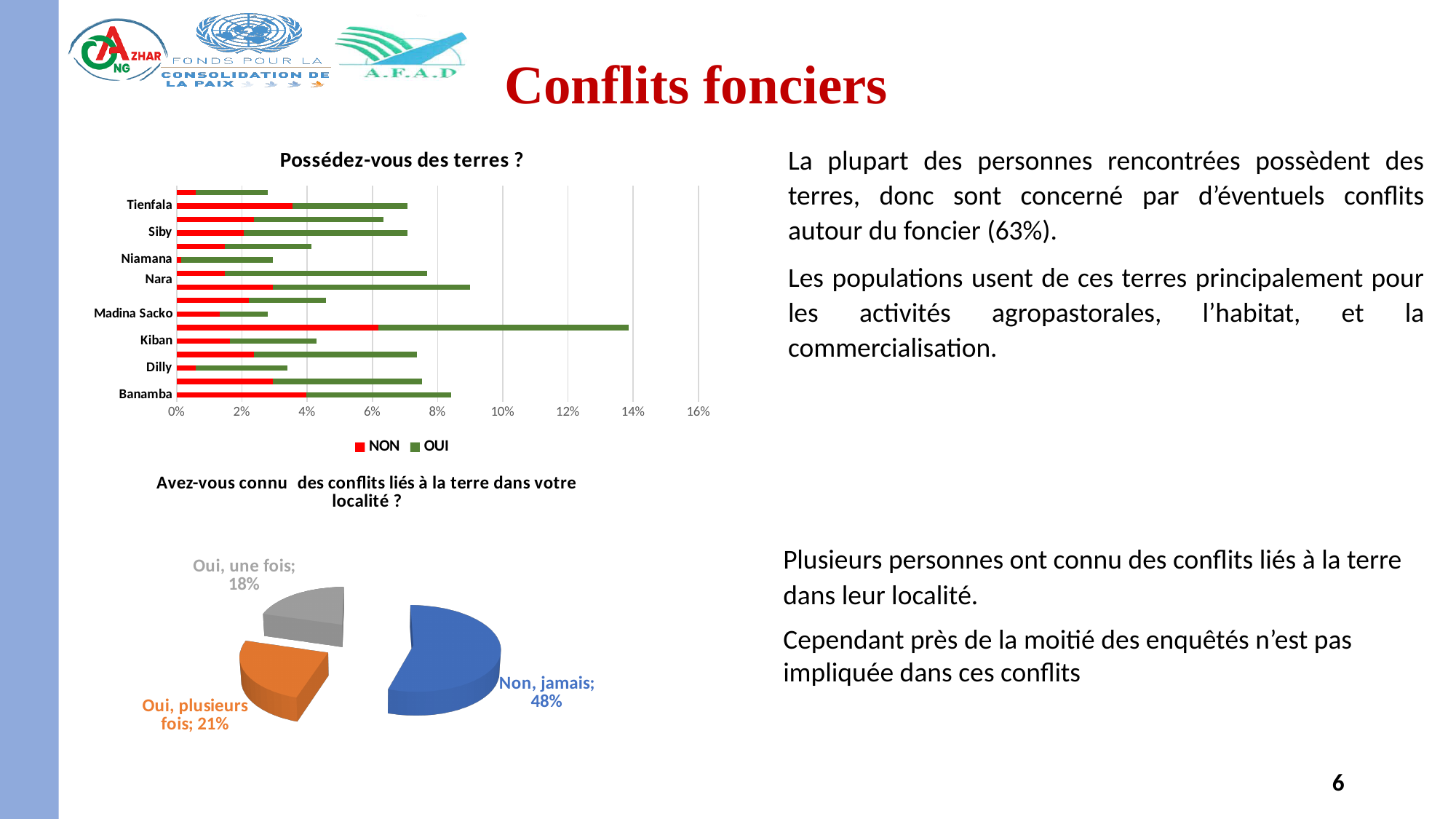
In the pie chart 'Avez-vous connu des conflits liés à la terre dans votre localité ?', what share is labelled 'Oui, une fois'? 18% In the pie chart 'Avez-vous connu des conflits liés à la terre dans votre localité ?', which slice is the largest? Non, jamais In the bar chart 'Possédez-vous des terres ?', how many series does the legend list? 2 In the pie chart 'Avez-vous connu des conflits liés à la terre dans votre localité ?', how many percentage points larger is 'Non, jamais' than 'Oui, plusieurs fois'? 27 In the pie chart 'Avez-vous connu des conflits liés à la terre dans votre localité ?', what share is labelled 'Oui, plusieurs fois'? 21% In the pie chart 'Avez-vous connu des conflits liés à la terre dans votre localité ?', which slice is the smallest? Oui, une fois In the pie chart 'Avez-vous connu des conflits liés à la terre dans votre localité ?', how many slices are shown? 3 In the bar chart 'Possédez-vous des terres ?', is the OUI value for Niamana greater or less than 4%? less In the pie chart 'Avez-vous connu des conflits liés à la terre dans votre localité ?', what share is labelled 'Non, jamais'? 48% In the bar chart 'Possédez-vous des terres ?', is the OUI value for Banamba greater or less than 6%? less What kind of chart is 'Possédez-vous des terres ?'? Bar chart In the bar chart 'Possédez-vous des terres ?', which is larger for Banamba, OUI or NON? OUI